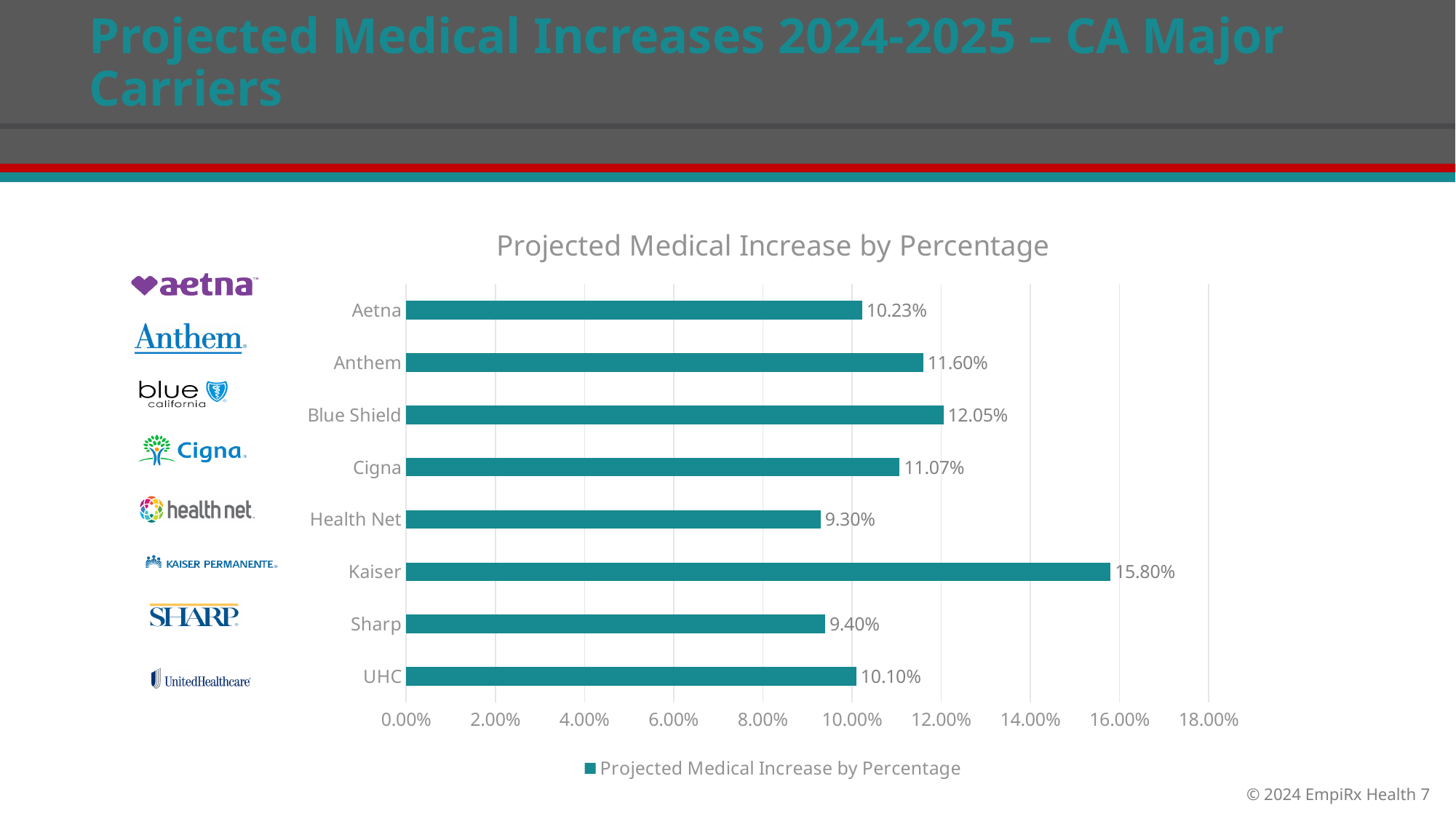
Which carrier has the lowest projected medical increase? Health Net How many carriers are shown in the chart? 8 What kind of chart is shown on the slide? Bar chart Which has a larger projected medical increase, Cigna or UHC? Cigna Which carrier has the highest projected medical increase? Kaiser What is the projected medical increase for Kaiser? 15.80% What is the difference between the projected medical increases for Kaiser and Health Net? 6.50% Is the value for Sharp greater or less than 10.00%? less What is the difference between the projected medical increases for Anthem and Aetna? 1.37% What is the projected medical increase for Health Net? 9.30% What is the projected medical increase for Blue Shield? 12.05% What is the title of the chart? Projected Medical Increase by Percentage